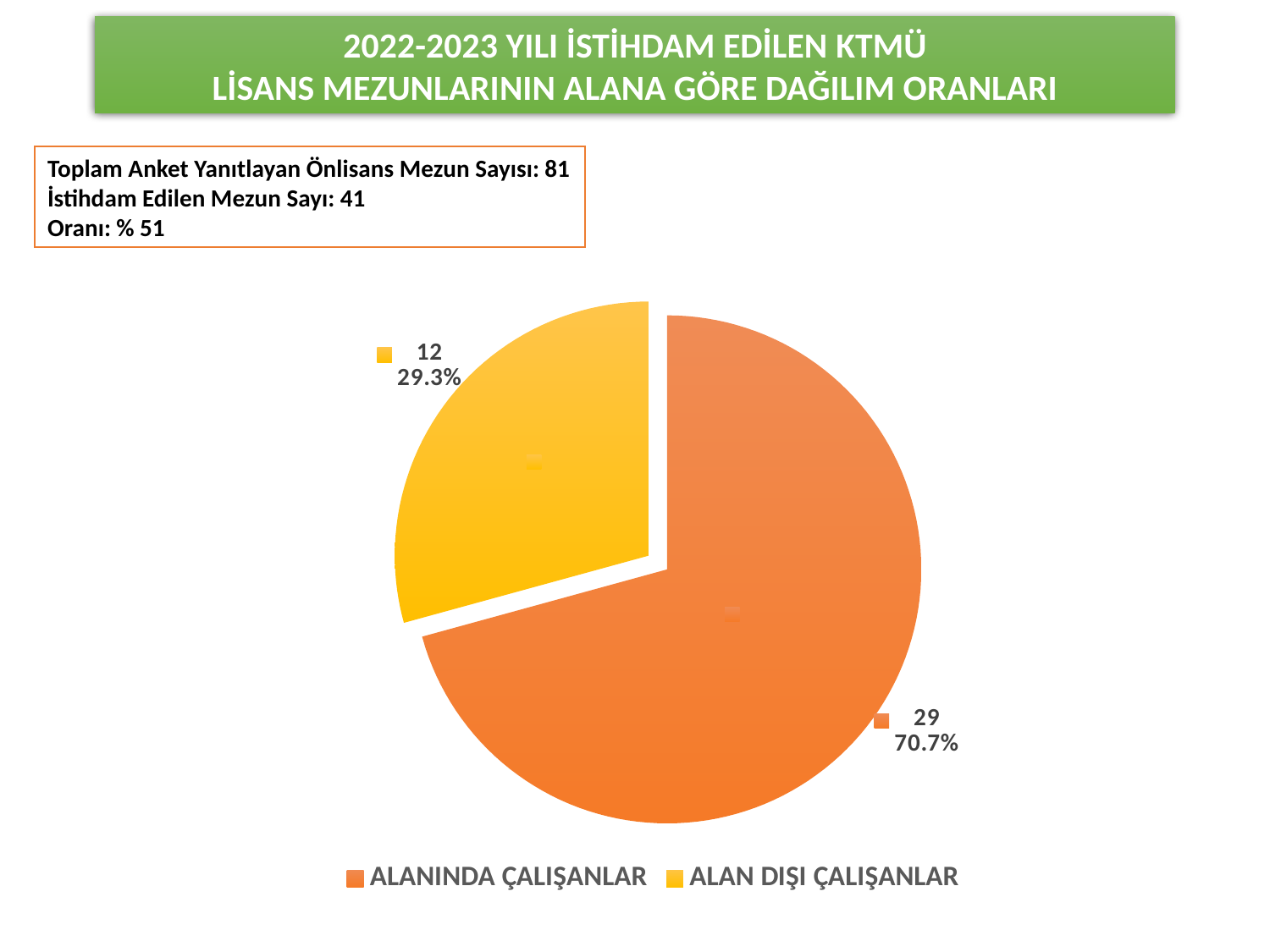
What colour is the ALAN DIŞI ÇALIŞANLAR slice in the pie chart? yellow Which is larger, the value for ALANINDA ÇALIŞANLAR or ALAN DIŞI ÇALIŞANLAR? ALANINDA ÇALIŞANLAR What percentage share does ALAN DIŞI ÇALIŞANLAR have in the pie chart? 29.3% How many slices does the pie chart have? 2 What is the difference between the values for ALANINDA ÇALIŞANLAR and ALAN DIŞI ÇALIŞANLAR? 17 What is the value for ALAN DIŞI ÇALIŞANLAR? 12 Which category has the largest slice in the pie chart? ALANINDA ÇALIŞANLAR What kind of chart is shown on the slide? pie chart Which category has the smallest slice in the pie chart? ALAN DIŞI ÇALIŞANLAR What is the value for ALANINDA ÇALIŞANLAR? 29 What percentage share does ALANINDA ÇALIŞANLAR have in the pie chart? 70.7% What is the total of the two slices in the pie chart? 41